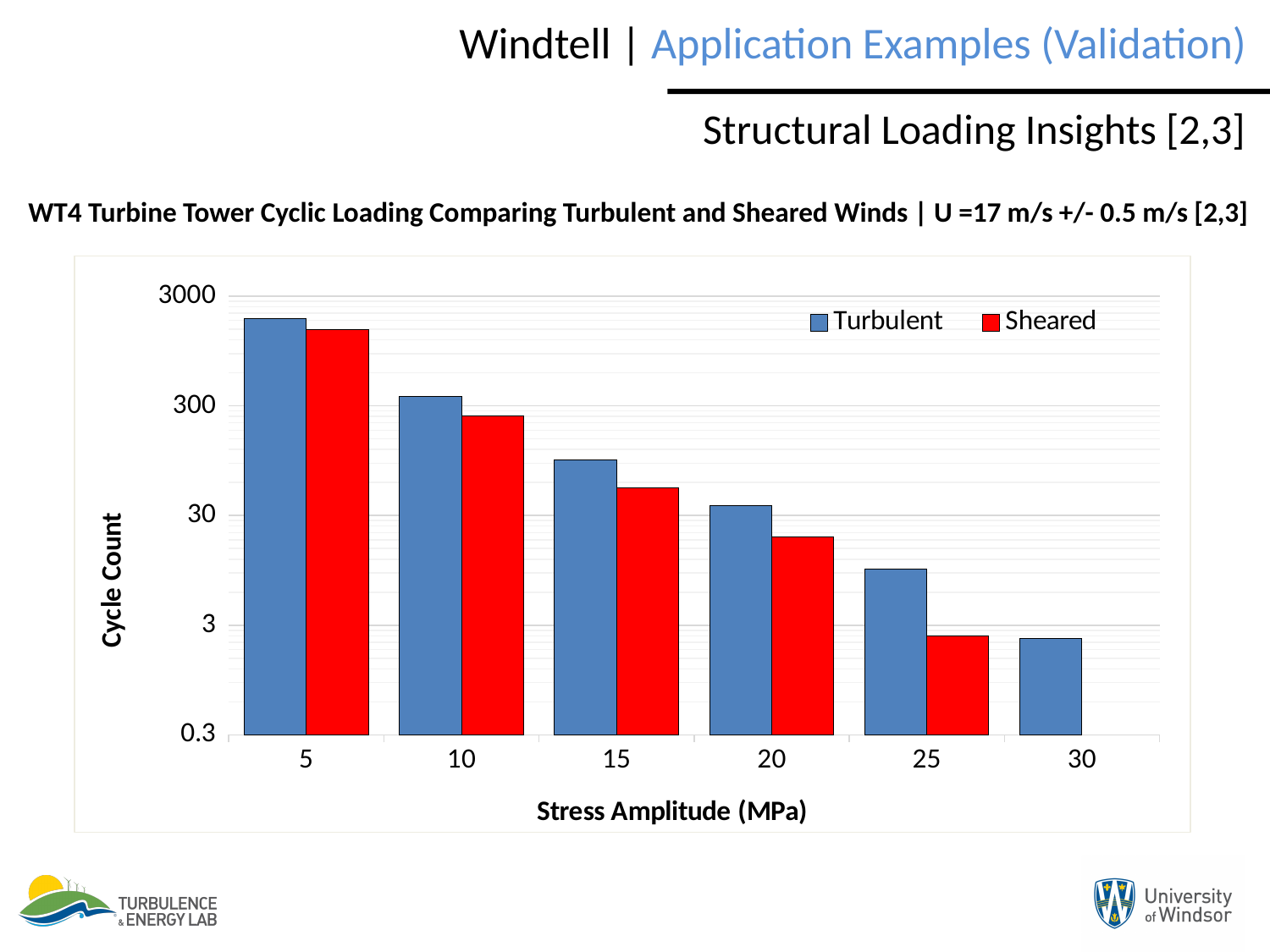
Which stress amplitude has the highest Turbulent cycle count? 5 Is the Turbulent cycle count at 5 MPa greater or less than 300? greater Which stress amplitude has the lowest Sheared cycle count? 25 Is the Turbulent cycle count at 15 MPa greater or less than 30? greater What is the label of the y axis? Cycle Count Is the Sheared cycle count at 20 MPa greater or less than 30? less Do the Turbulent cycle counts rise or fall as stress amplitude increases? fall How many series does the legend list? 2 At 25 MPa, which series has the larger cycle count, Turbulent or Sheared? Turbulent How many stress amplitude categories are shown on the x axis? 6 What kind of chart is shown on the slide? bar chart